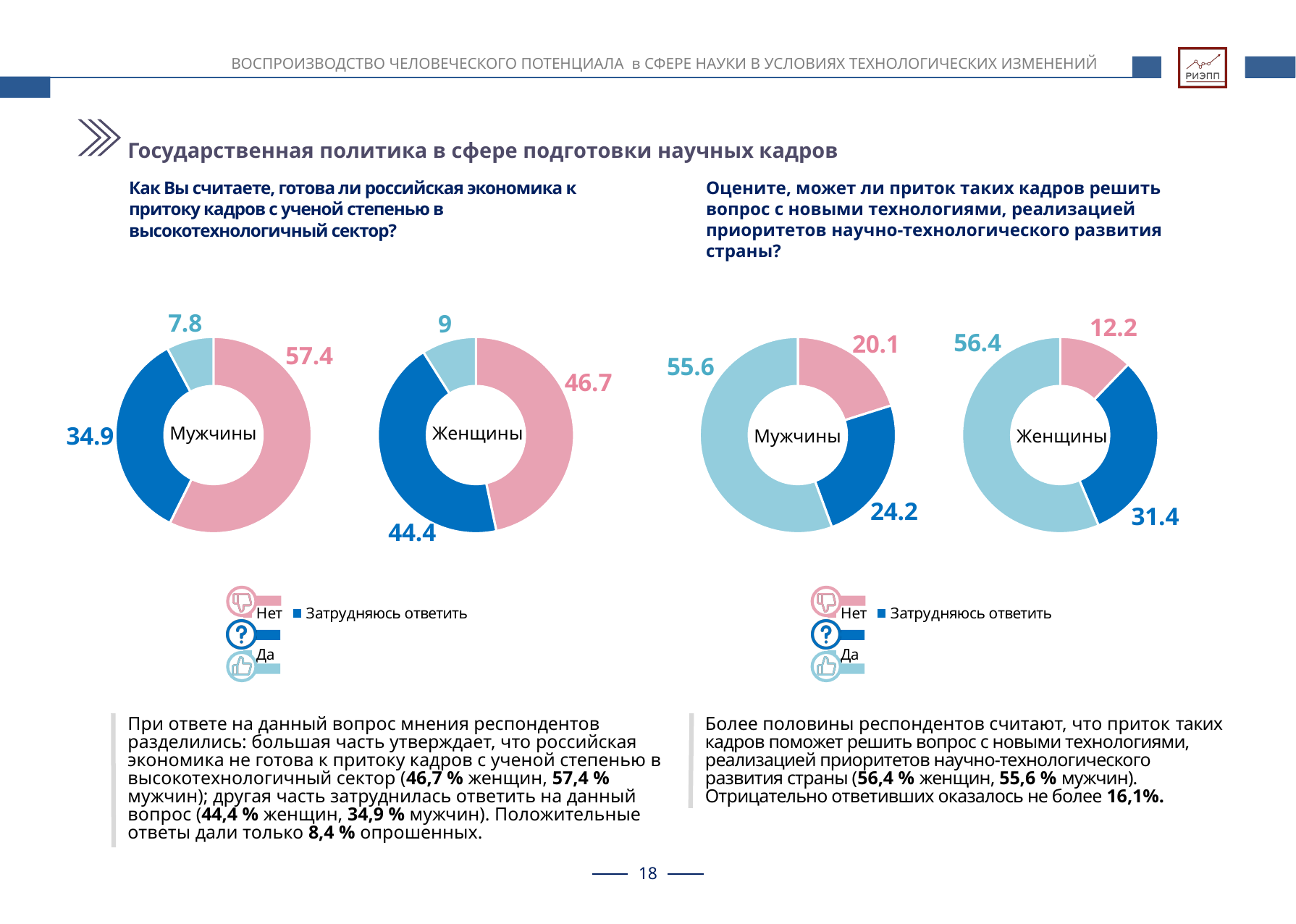
How many segments does each donut chart on the slide have? 3 In the right-hand 'Женщины' donut chart (about whether the inflow of personnel can solve the issue of new technologies), what is the value for 'Затрудняюсь ответить'? 31.4 In the right-hand 'Женщины' donut chart, which answer has the smallest share? Нет In the left-hand 'Мужчины' donut chart, which answer has the largest share? Нет In the left-hand 'Женщины' donut chart (about whether the Russian economy is ready for an inflow of personnel with academic degrees), what is the value for 'Да'? 9 In the left-hand 'Мужчины' donut chart (about whether the Russian economy is ready for an inflow of personnel with academic degrees), what is the value for 'Нет'? 57.4 What type of chart is used to show the survey results on this slide? Donut (pie) chart In the left-hand 'Мужчины' donut chart, what is the difference between the 'Нет' value and the 'Затрудняюсь ответить' value? 22.5 In the right-hand 'Мужчины' donut chart, which is larger: 'Нет' or 'Затрудняюсь ответить'? Затрудняюсь ответить In the right-hand 'Мужчины' donut chart (about whether the inflow of personnel can solve the issue of new technologies), what is the value for 'Да'? 55.6 In the legends on the slide, which answer does the pink colour represent? Нет How many entries does the legend below the left-hand charts list? 3